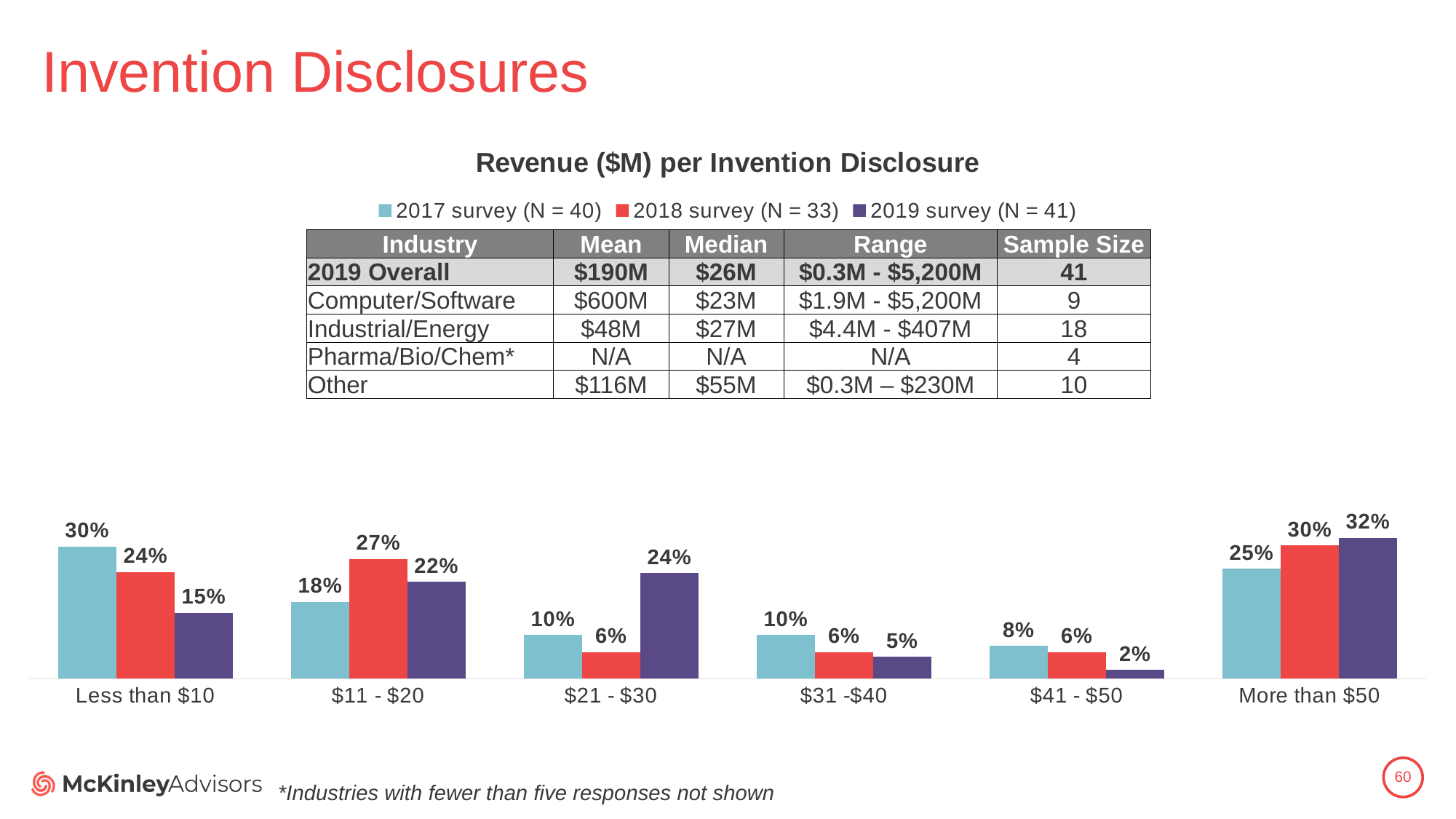
What is the value for the 2019 survey in the 'Less than $10' category? 15% How many series does the chart legend list? 3 What kind of chart is shown on the slide? Bar chart How many revenue categories are shown on the x axis of the chart? 6 What is the sample size for the 2019 survey according to the legend? 41 What is the title of the chart? Revenue ($M) per Invention Disclosure What is the difference between the 2017 survey and 2019 survey values in the 'Less than $10' category? 15% What is the value for the 2017 survey in the '$21 - $30' category? 10% Which category has the lowest value for the 2019 survey? $41 - $50 What is the value for the 2018 survey in the 'More than $50' category? 30% Which is larger in the '$21 - $30' category: the 2018 survey value or the 2019 survey value? 2019 survey Which category has the highest value for the 2019 survey? More than $50